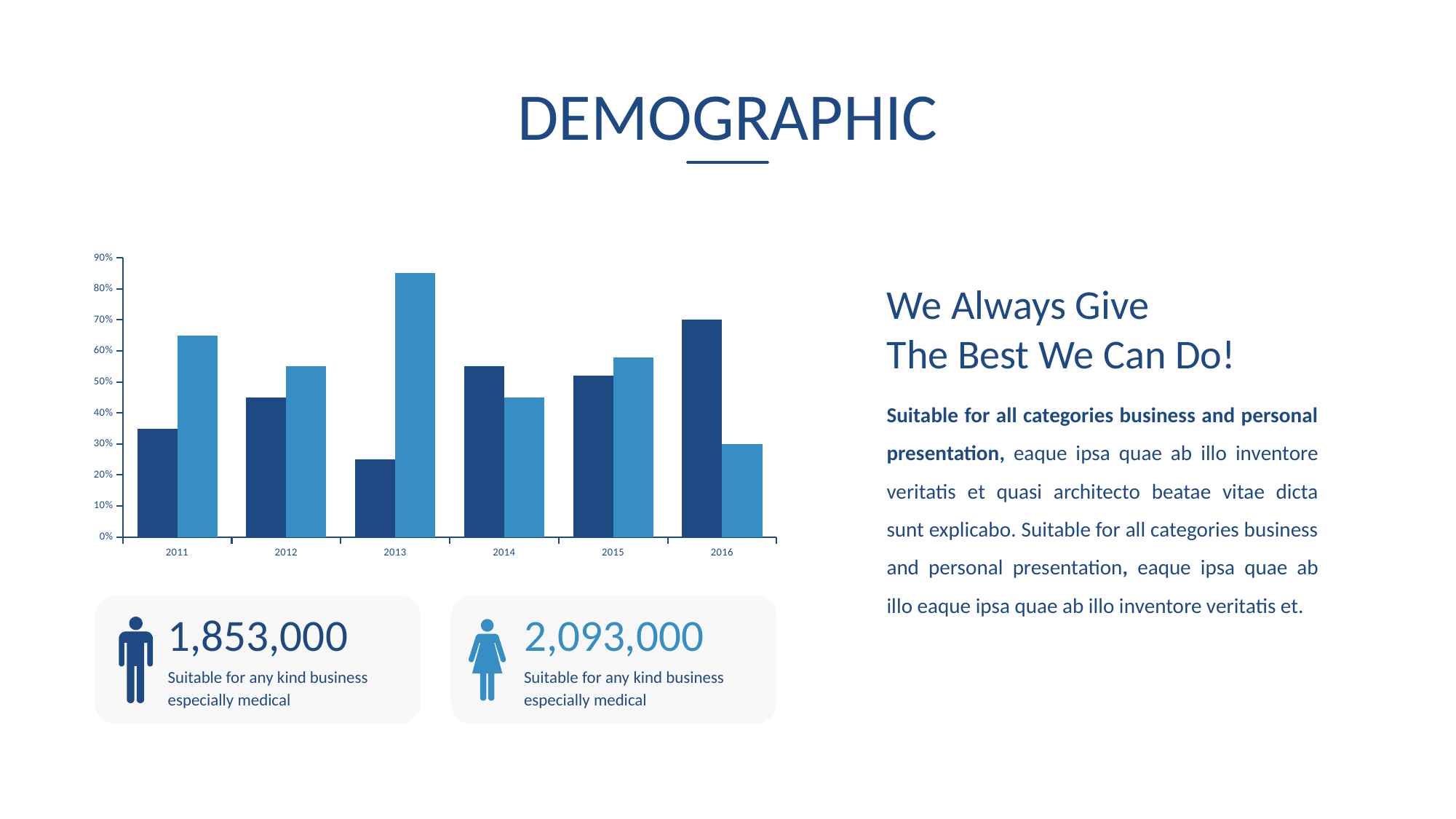
How many years are shown on the x axis of the chart? 6 How many bars are plotted for each year in the chart? 2 What kind of chart is shown on the slide? bar chart In which year is the dark blue bar the shortest? 2013 What is the value of the dark blue bar for 2016? 70% For 2011, which bar is taller, the dark blue or the light blue? light blue In which year is the dark blue bar the tallest? 2016 What is the highest value shown on the chart's vertical axis? 90% In which year is the light blue bar the tallest? 2013 In which year is the light blue bar the shortest? 2016 Is the value of the light blue bar for 2013 greater or less than 80%? greater Is the value of the dark blue bar for 2011 greater or less than 40%? less